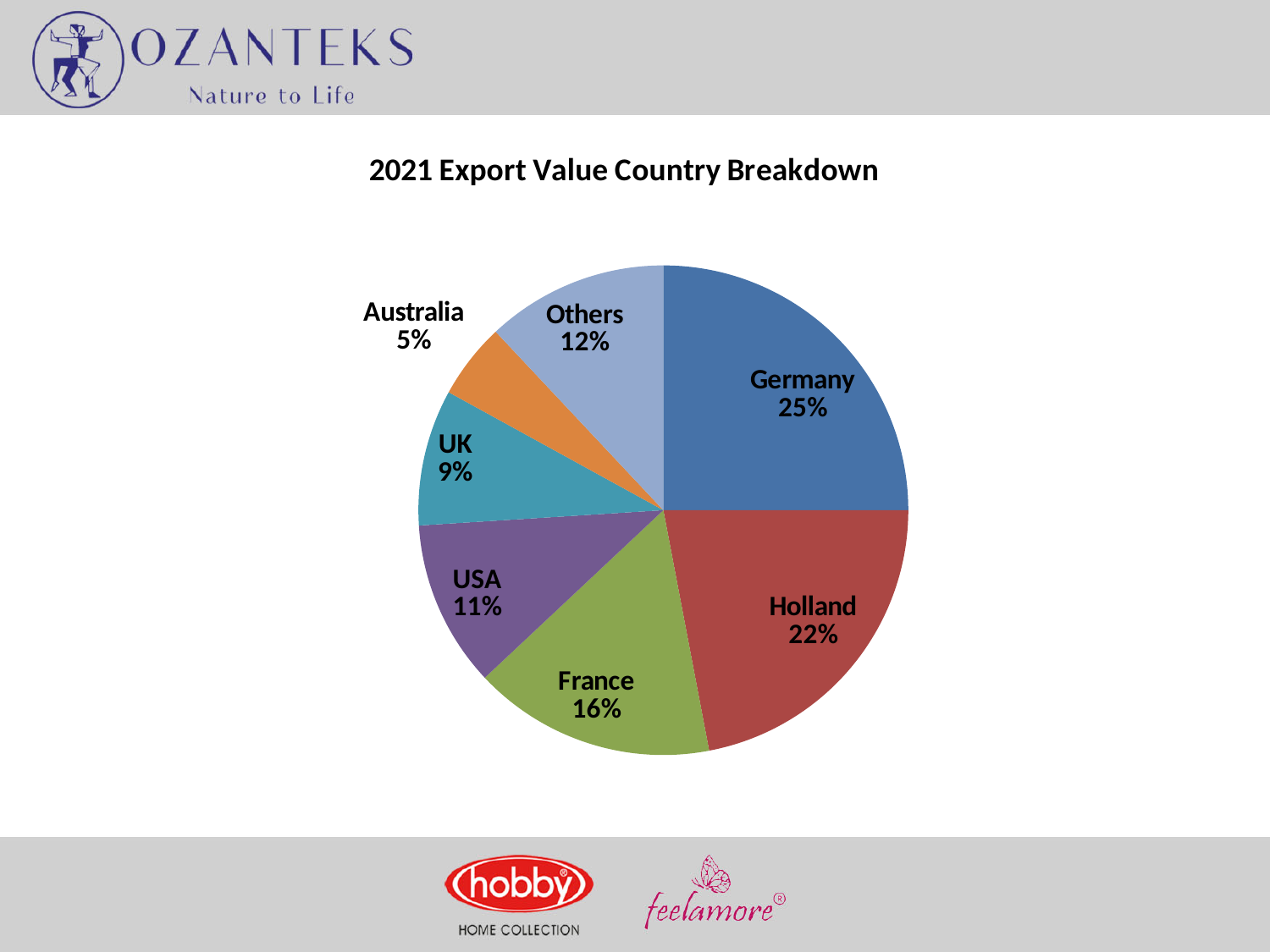
Which country has the largest share of the 2021 export value? Germany Which category has the smallest slice in the pie chart? Australia What percentage is shown for Holland? 22% What type of chart is shown on the slide? pie chart Which has a larger share, USA or UK? USA What percentage is shown for France? 16% What share of the 2021 export value does Germany account for? 25% How many slices does the pie chart have? 7 What share does Australia have in the chart? 5% What is the difference in percentage points between Germany and Holland? 3 What is the title of the chart? 2021 Export Value Country Breakdown What is the combined share of Germany and Holland? 47%